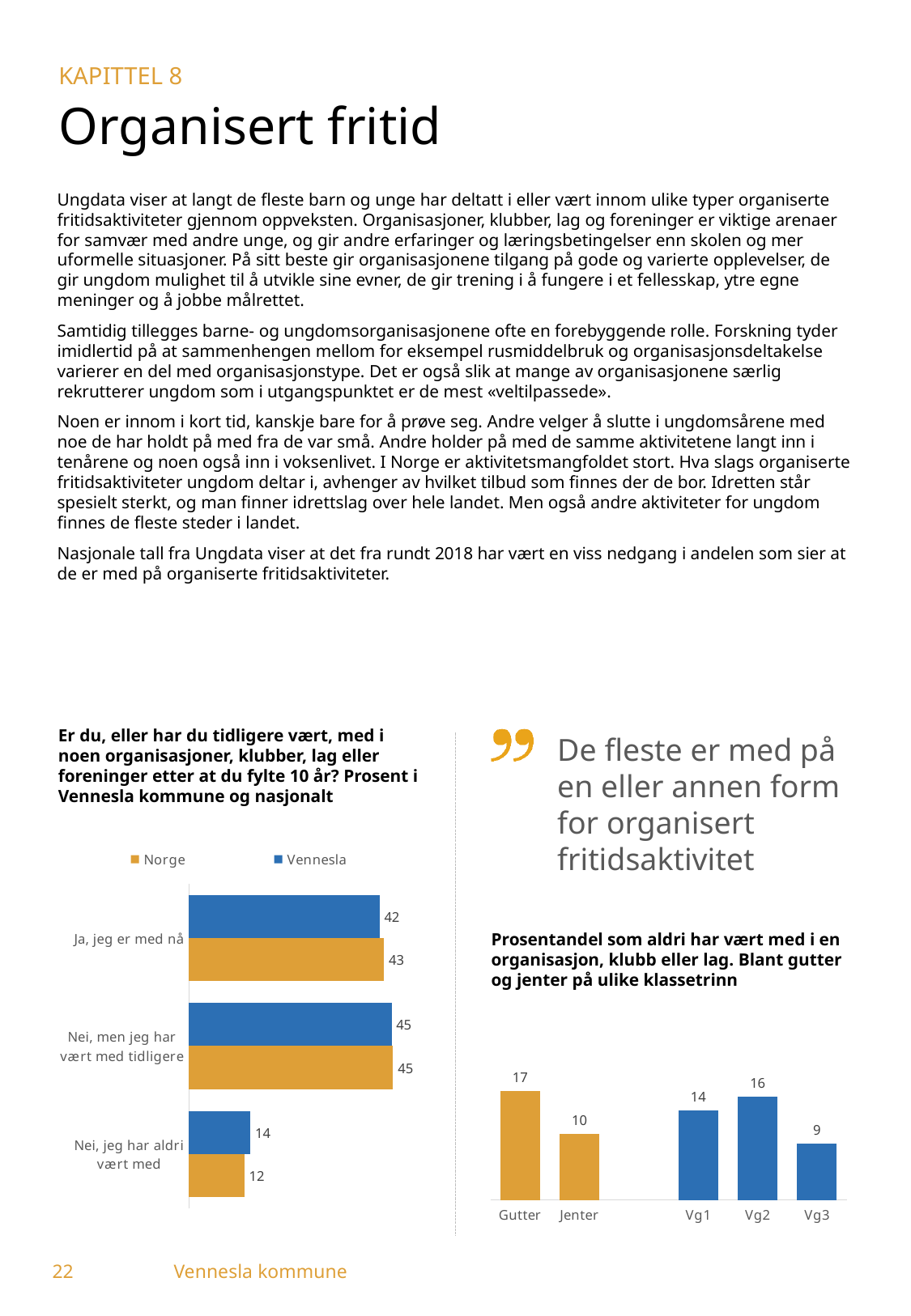
In the left chart, which is larger for "Ja, jeg er med nå": the Norge value or the Vennesla value? Norge In the left chart, what is the difference between the Vennesla and Norge values for "Nei, jeg har aldri vært med"? 2 In the left chart ("Er du, eller har du tidligere vært, med i noen organisasjoner..."), what is the value for Vennesla for "Ja, jeg er med nå"? 42 How many categories are shown in the right chart? 5 In the right chart, what is the difference between the values for Gutter and Jenter? 7 How many series does the legend of the left chart list? 2 In the left chart, what is the value for Norge for "Nei, jeg har aldri vært med"? 12 In the right chart ("Prosentandel som aldri har vært med i en organisasjon, klubb eller lag"), what is the value for Jenter? 10 In the left chart, which category has the lowest value for Vennesla? Nei, jeg har aldri vært med In the right chart, which category has the lowest value? Vg3 What kind of chart is the left chart? Bar chart In the right chart, which category has the highest value? Gutter